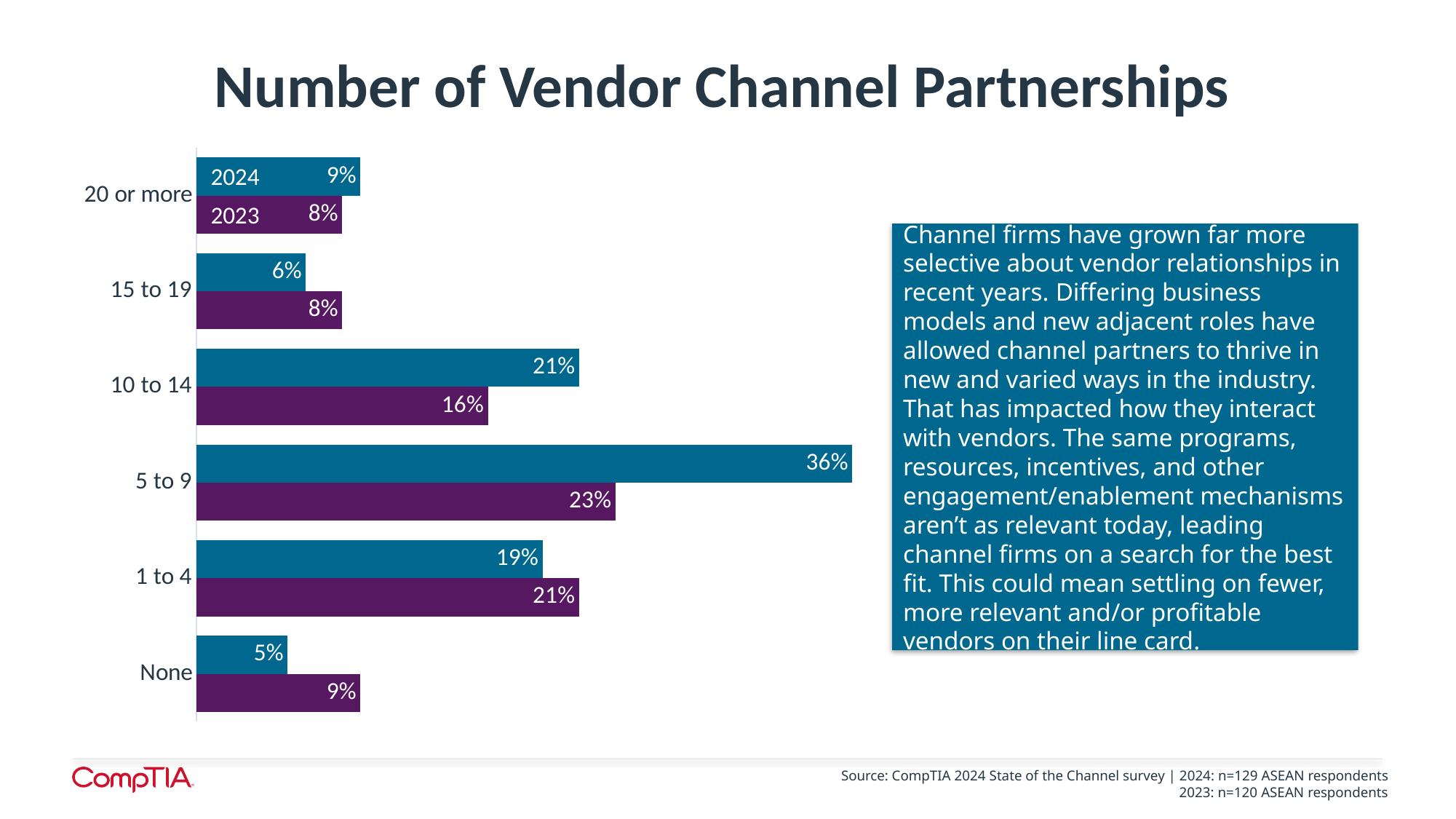
What is the 2024 value for 'None'? 5% What is the 2023 value for the '10 to 14' category? 16% Which category has the lowest 2024 value? None How many series does the chart show? 2 What kind of chart is shown on the slide? Bar chart Which category has the highest 2024 value? 5 to 9 Which colour represents the 2023 series? Purple For the '1 to 4' category, which year has the larger value, 2024 or 2023? 2023 How many categories are shown on the chart? 6 What is the difference between the 2024 and 2023 values for '5 to 9'? 13 percentage points What is the 2024 value for the '5 to 9' category? 36% What is the title of the chart? Number of Vendor Channel Partnerships